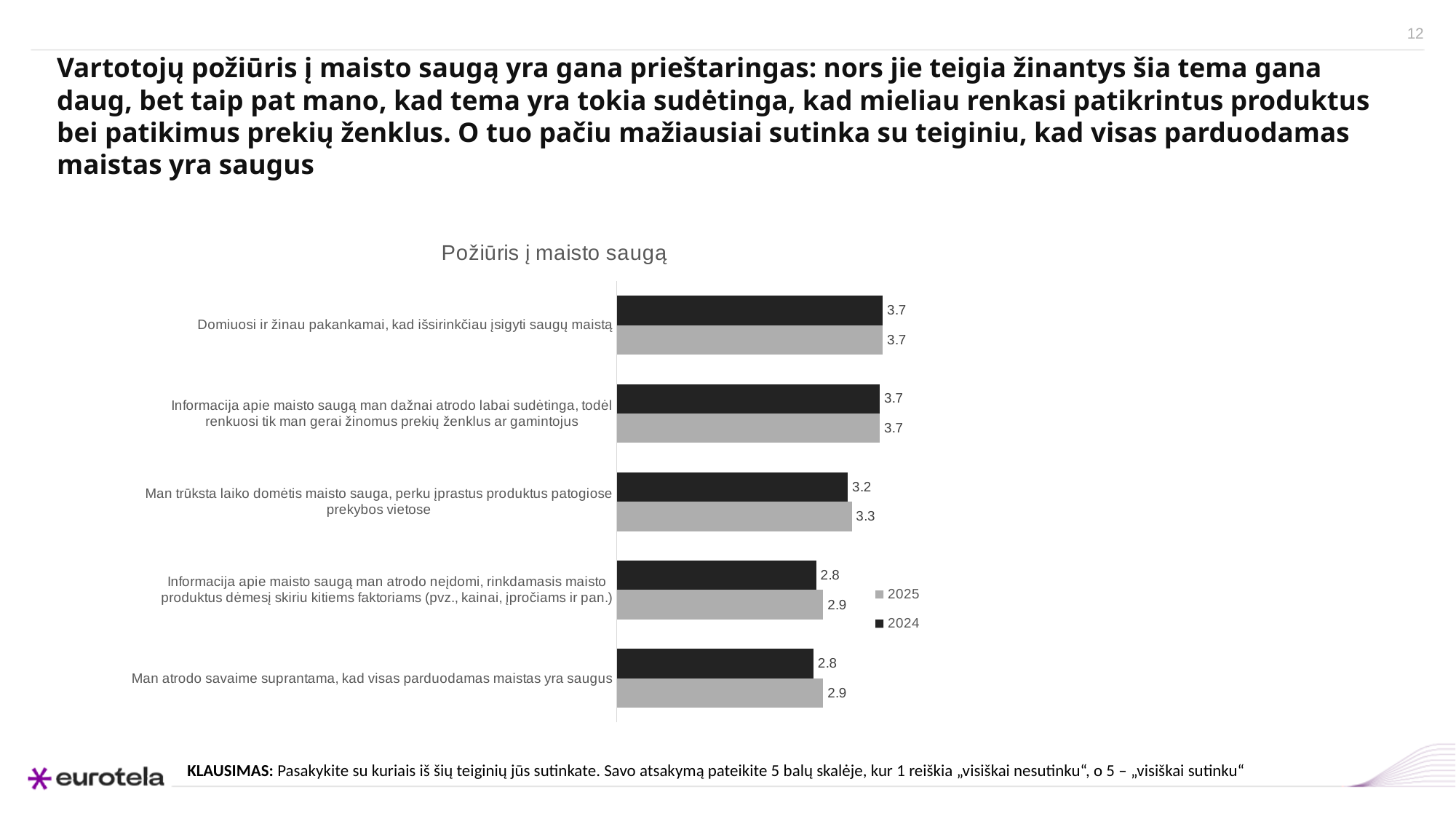
What is the 2024 value for "Domiuosi ir žinau pakankamai, kad išsirinkčiau įsigyti saugų maistą"? 3.7 What is the difference between the 2025 and 2024 values for "Man atrodo savaime suprantama, kad visas parduodamas maistas yra saugus"? 0.1 What type of chart is shown on the slide? Bar chart Which is larger for "Man trūksta laiko domėtis maisto sauga, perku įprastus produktus patogiose prekybos vietose": the 2024 value or the 2025 value? 2025 Which colour represents the 2024 series in the chart? Black How many statements (categories) are shown in the chart? 5 What is the 2024 value for "Man trūksta laiko domėtis maisto sauga, perku įprastus produktus patogiose prekybos vietose"? 3.2 What is the 2025 value for "Man atrodo savaime suprantama, kad visas parduodamas maistas yra saugus"? 2.9 What is the 2024 value for "Informacija apie maisto saugą man atrodo neįdomi, rinkdamasis maisto produktus dėmesį skiriu kitiems faktoriams (pvz., kainai, įpročiams ir pan.)"? 2.8 What is the 2025 value for "Man trūksta laiko domėtis maisto sauga, perku įprastus produktus patogiose prekybos vietose"? 3.3 What is the title of the chart? Požiūris į maisto saugą How many series does the chart legend list? 2